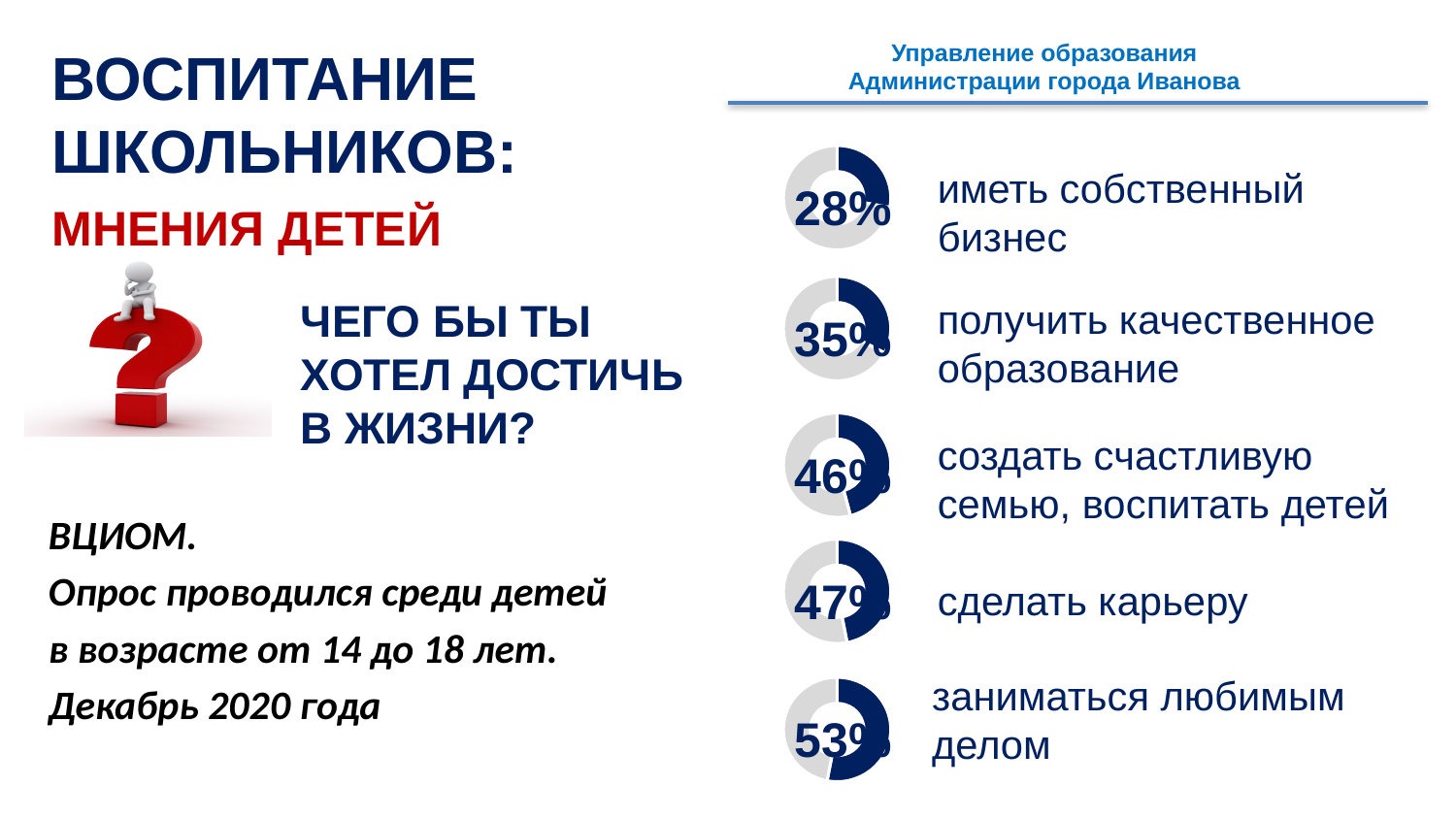
What percentage of respondents chose "иметь собственный бизнес"? 28% Which life goal has the highest percentage on the slide? заниматься любимым делом What percentage is shown for "заниматься любимым делом"? 53% Which life goal has the lowest percentage on the slide? иметь собственный бизнес What question do the charts on the slide answer? ЧЕГО БЫ ТЫ ХОТЕЛ ДОСТИЧЬ В ЖИЗНИ? What kind of chart is used to show each percentage on the slide? doughnut chart What percentage is shown for "получить качественное образование"? 35% How many circular charts are shown on the slide? 5 Which has a larger share: "сделать карьеру" or "получить качественное образование"? сделать карьеру What is the difference in percentage points between "заниматься любимым делом" and "иметь собственный бизнес"? 25 What percentage of respondents chose "сделать карьеру"? 47% What percentage is shown for "создать счастливую семью, воспитать детей"? 46%